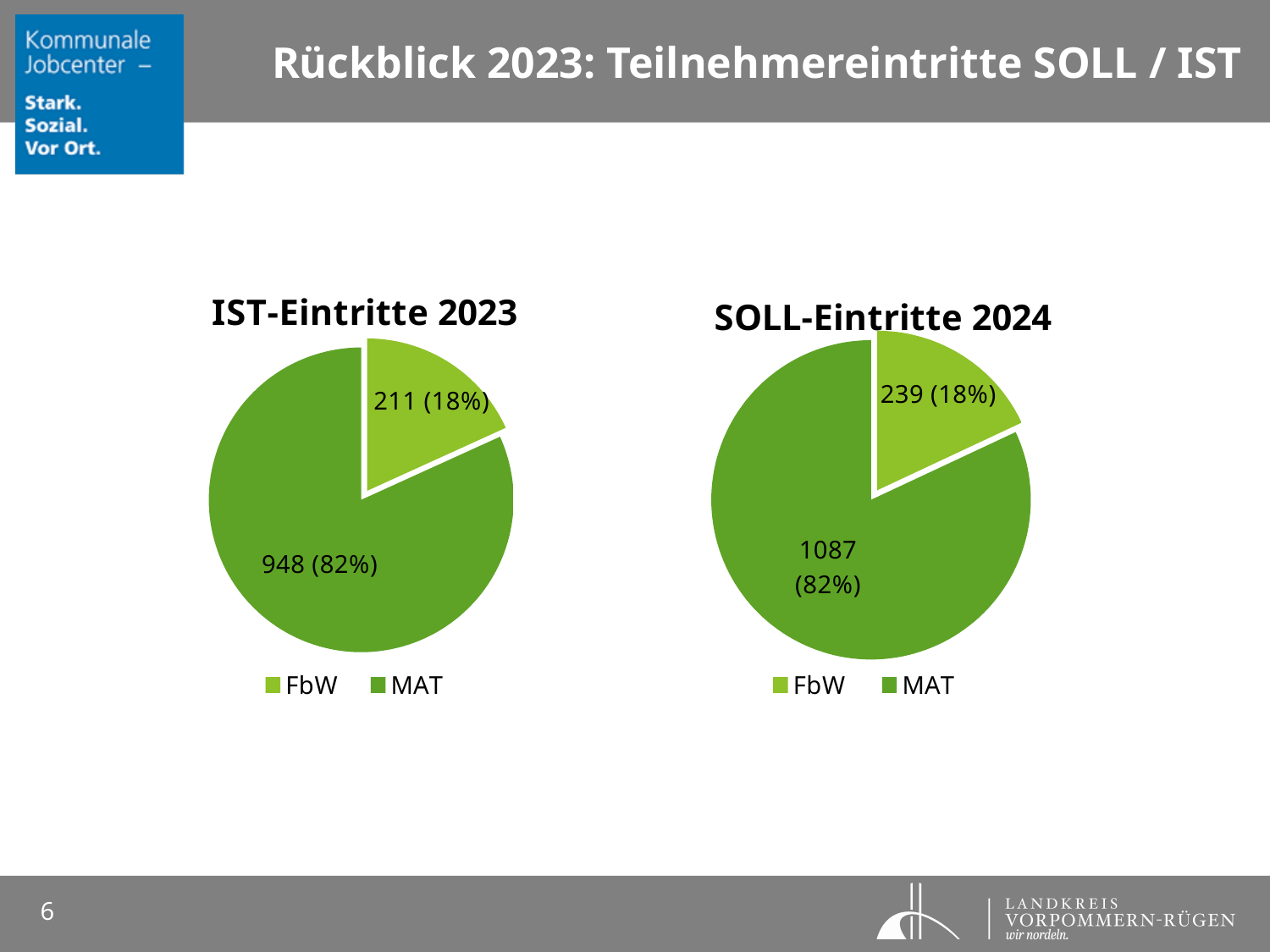
In the 'IST-Eintritte 2023' chart, which category is the largest? MAT What kind of chart is 'SOLL-Eintritte 2024'? Pie chart In the 'IST-Eintritte 2023' chart, what is the value for MAT? 948 In the 'SOLL-Eintritte 2024' chart, what is the value for MAT? 1087 In the 'IST-Eintritte 2023' chart, what is the value for FbW? 211 In the 'SOLL-Eintritte 2024' chart, what is the total of the two slices? 1326 How many entries does the legend of the 'IST-Eintritte 2023' chart list? 2 In the 'IST-Eintritte 2023' chart, what share of the pie does MAT have? 82% In the 'SOLL-Eintritte 2024' chart, which category is the smallest? FbW In the 'IST-Eintritte 2023' chart, what is the difference between the MAT and FbW values? 737 In the 'SOLL-Eintritte 2024' chart, what share of the pie does FbW have? 18% In the 'SOLL-Eintritte 2024' chart, what is the value for FbW? 239